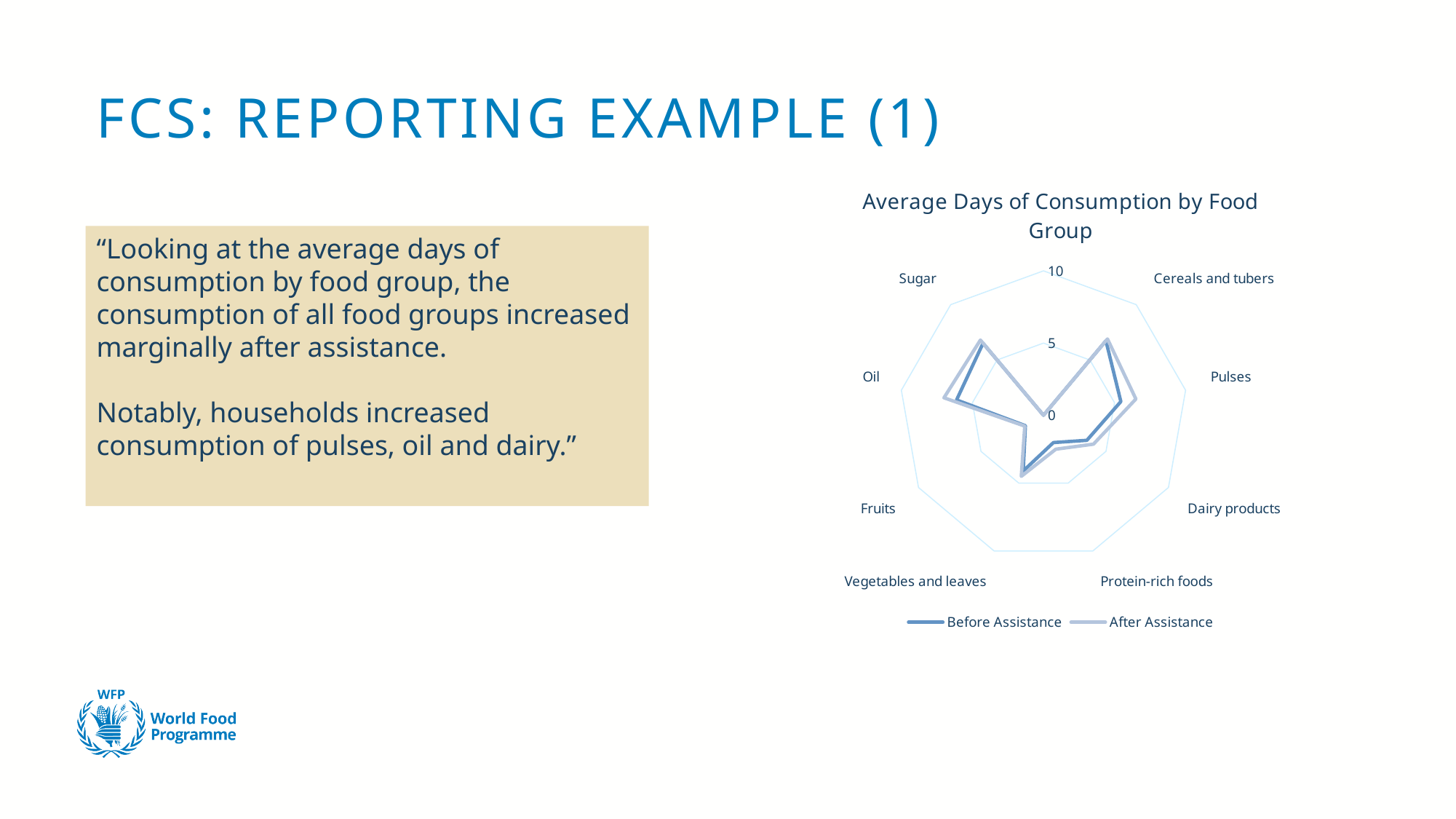
How many series does the chart's legend list? 2 Which has a higher average days of consumption, Sugar or Protein-rich foods? Sugar How many food groups are plotted on the chart? 8 Is the value for Sugar greater or less than 5? greater Is the value for Cereals and tubers greater or less than 5? greater Is the value for Fruits greater or less than 5? less Which food group has the lowest average days of consumption on the chart? Fruits Which has a higher average days of consumption, Cereals and tubers or Fruits? Cereals and tubers What kind of chart is shown on the slide? Radar chart What are the two series named in the chart's legend? Before Assistance and After Assistance What is the title of the chart? Average Days of Consumption by Food Group